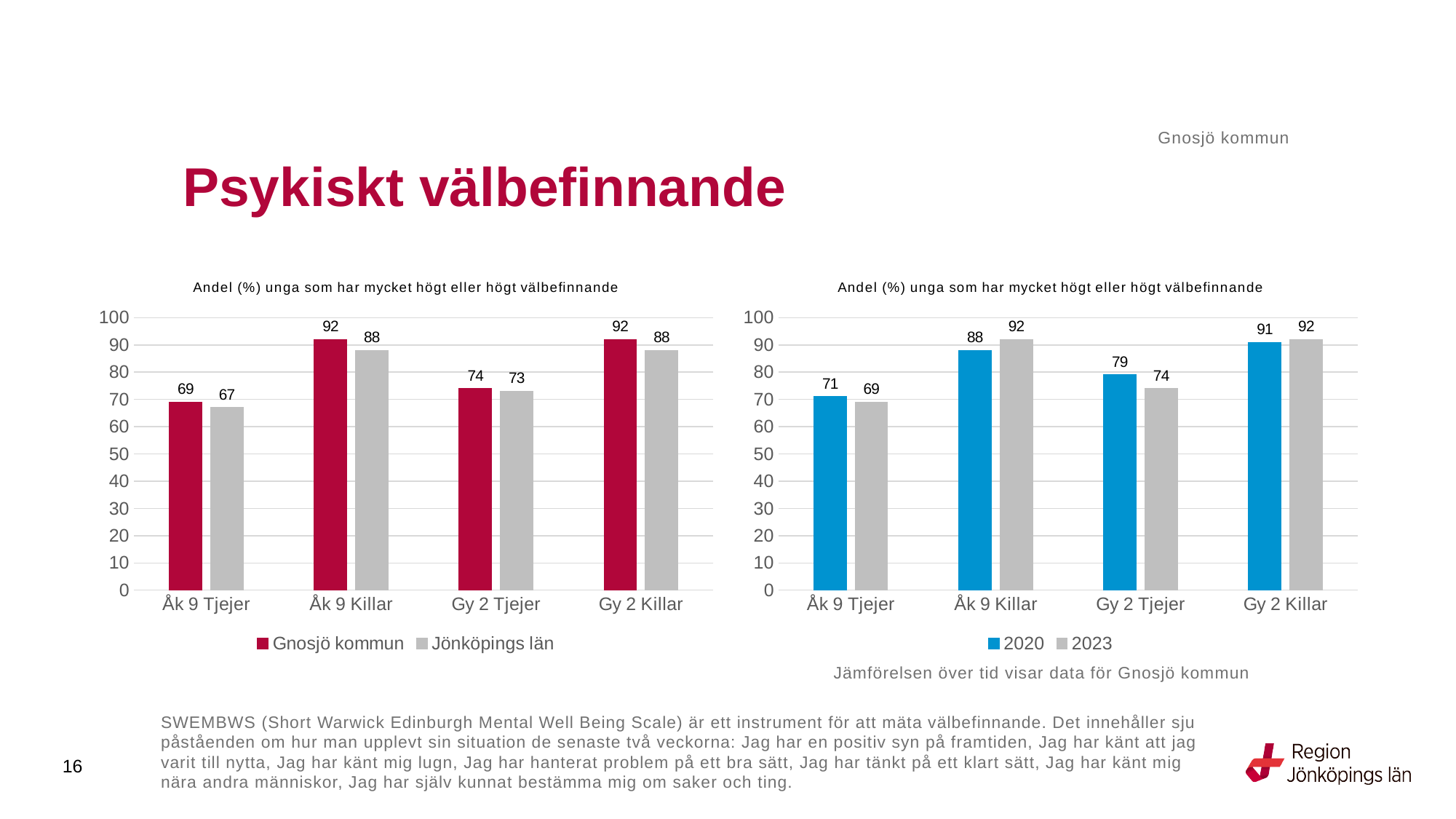
How many categories are shown on the x axis of the left chart? 4 In the right chart, what is the value for 2020 for Gy 2 Tjejer? 79 In the left chart, what is the value for Jönköpings län for Gy 2 Killar? 88 In the right chart, what is the difference between 2020 and 2023 for Gy 2 Tjejer? 5 In the right chart, which is larger for Åk 9 Killar: 2020 or 2023? 2023 In the left chart, what is the value for Gnosjö kommun for Åk 9 Tjejer? 69 In the right chart, what is the value for 2023 for Åk 9 Tjejer? 69 How many series does the legend of the right chart list? 2 What type of chart is the left chart? Bar chart In the left chart, what is the difference between Gnosjö kommun and Jönköpings län for Åk 9 Killar? 4 In the left chart, which category has the lowest value for Gnosjö kommun? Åk 9 Tjejer In the right chart, which category has the highest value for 2023? Åk 9 Killar and Gy 2 Killar (both 92)